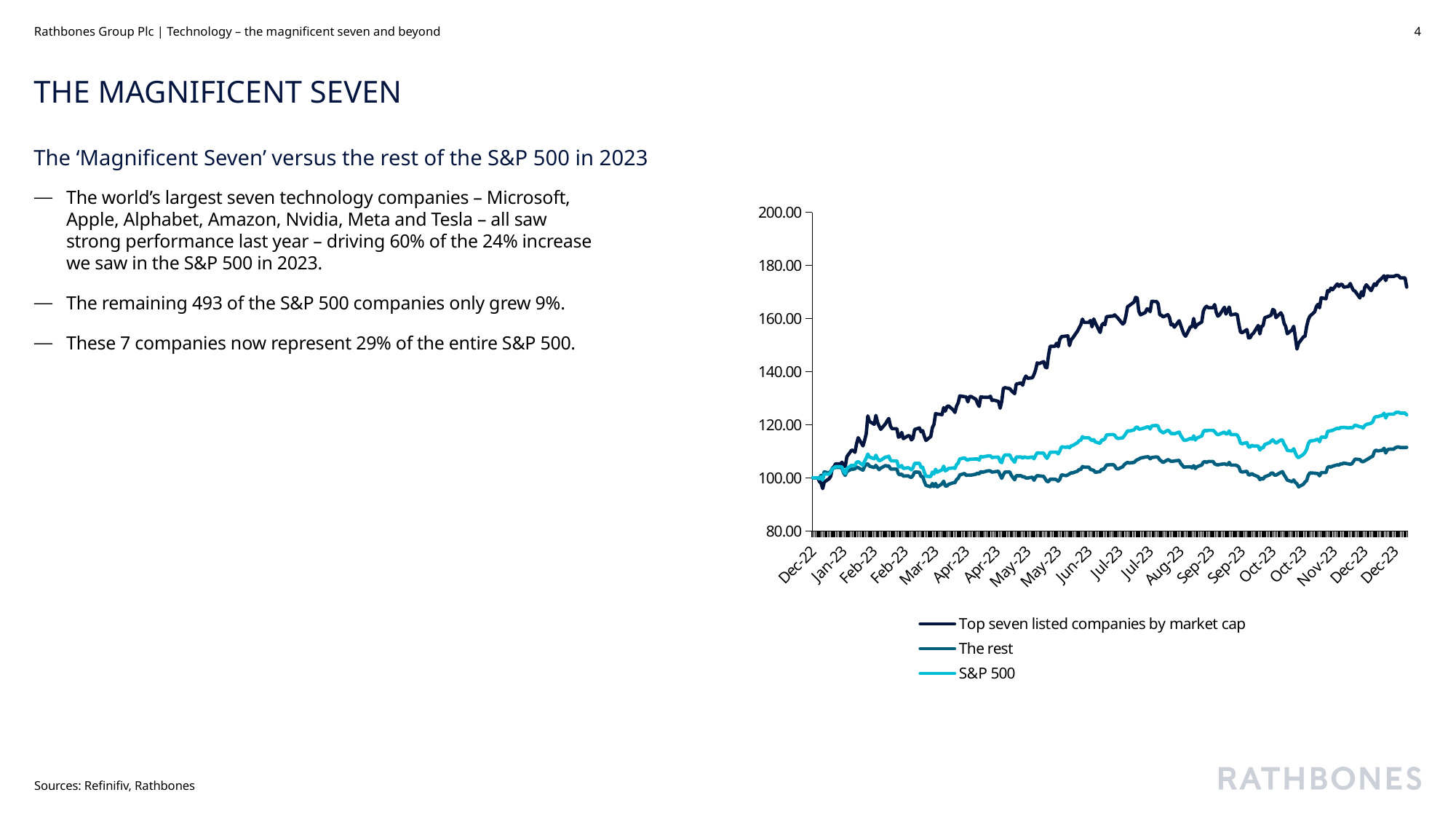
Does the Top seven listed companies by market cap line rise or fall overall from Dec-22 to Dec-23? rise What is the highest value shown on the chart's vertical axis? 200.00 Is the value for S&P 500 at Dec-23 greater or less than 120? greater Is the value for Top seven listed companies by market cap at Dec-23 greater or less than 160? greater What kind of chart is shown on the slide? line chart Which series is lowest at the end of the chart (Dec-23)? The rest Is the value for The rest at Dec-23 greater or less than 120? less What are the three series named in the chart's legend? Top seven listed companies by market cap, The rest, S&P 500 At Dec-23, which is larger: the S&P 500 line or The rest line? S&P 500 Which series is highest at the end of the chart (Dec-23)? Top seven listed companies by market cap How many series does the chart's legend list? 3